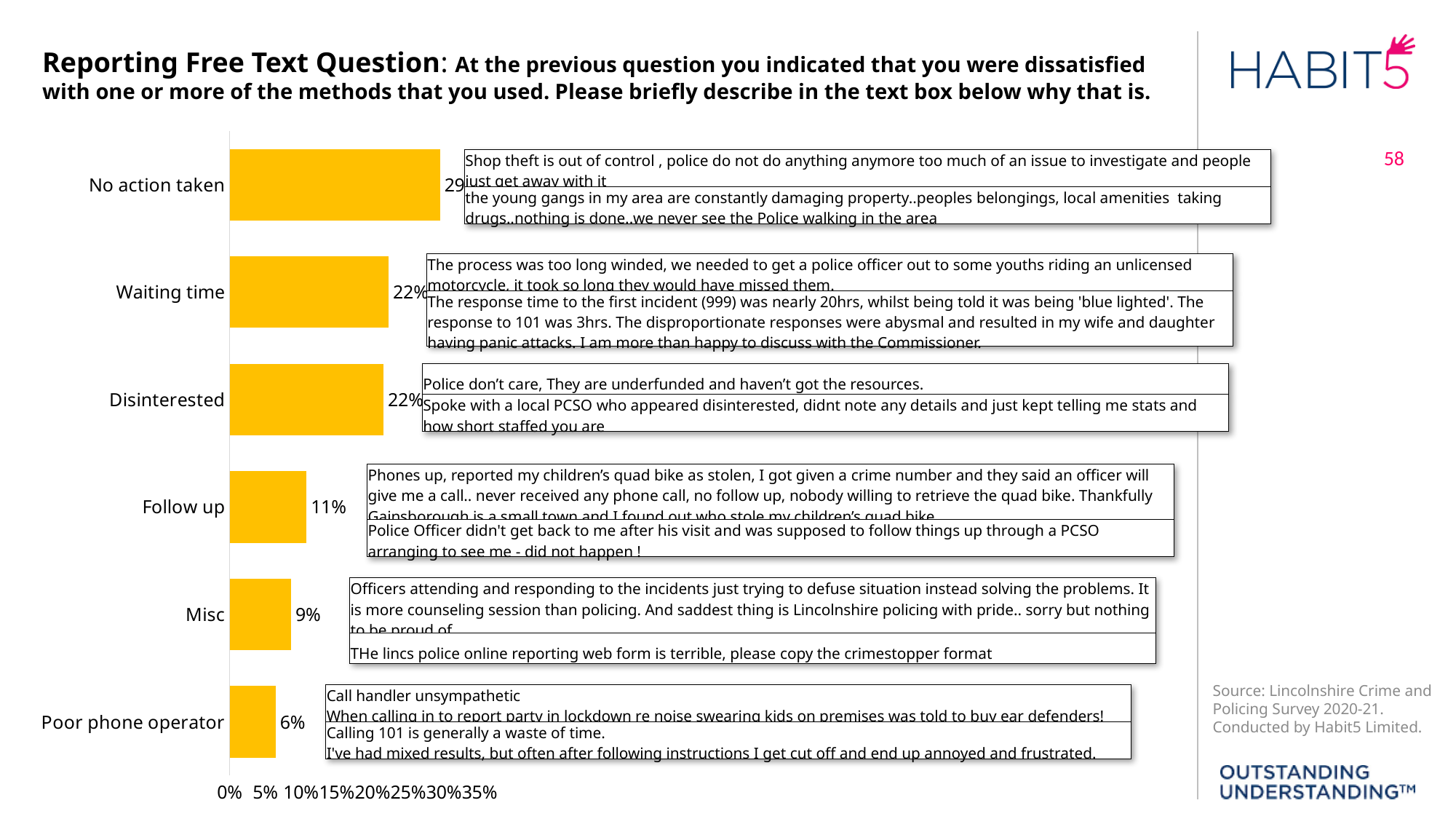
How many categories are shown in the chart? 6 Which is larger, the value for Follow up or the value for Misc? Follow up What is the value for Misc? 9% What is the difference between the values for Follow up and Poor phone operator? 5% Which category has the lowest value? Poor phone operator Is the value for No action taken greater or less than 25%? greater What kind of chart is shown on the slide? Bar chart What is the difference between the values for Waiting time and Follow up? 11% Which category has the highest value? No action taken What is the value for Poor phone operator? 6% What is the value for Waiting time? 22% What is the value for Follow up? 11%